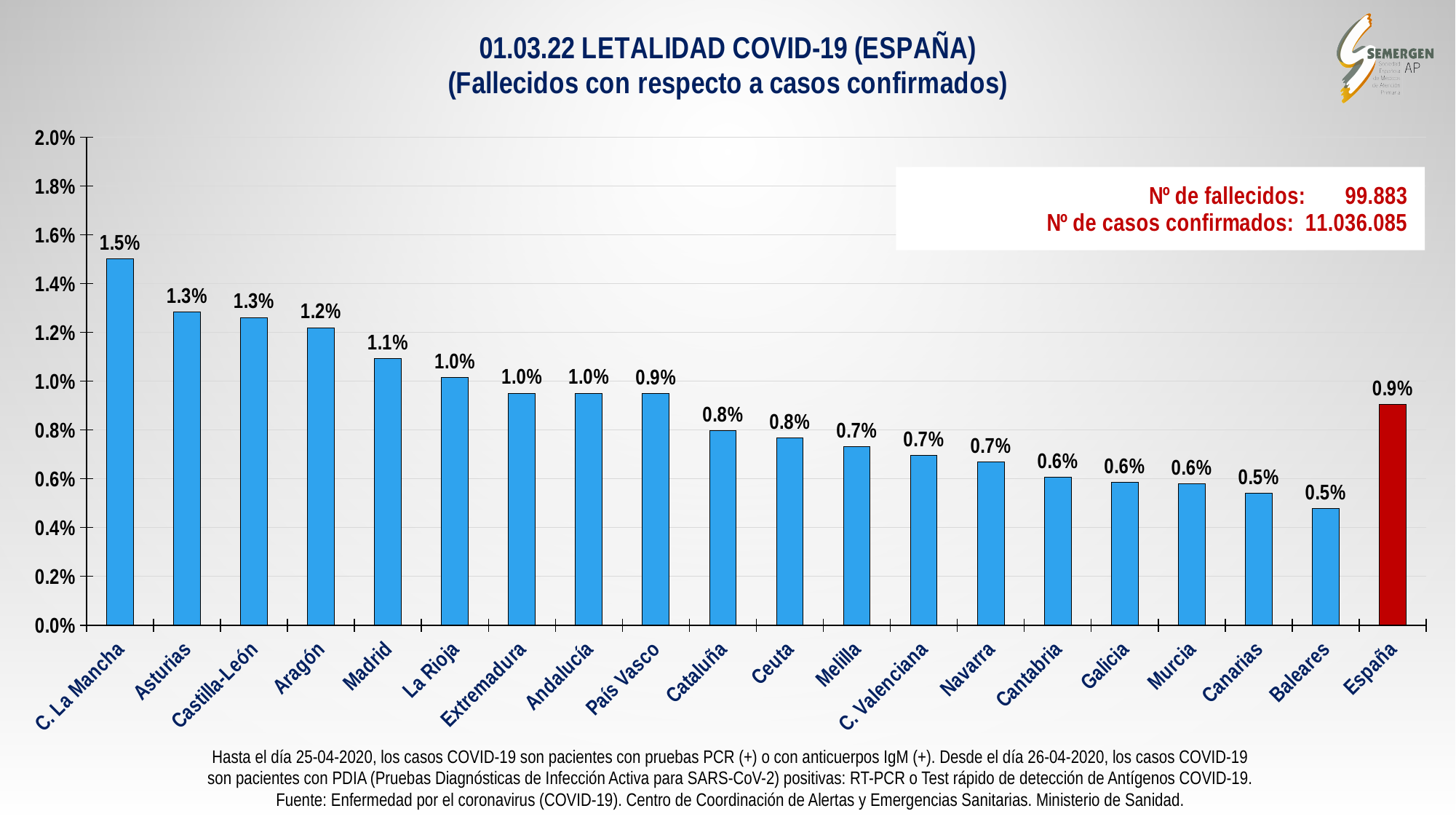
What is the lethality value shown for España? 0.9% Which has a larger value, Aragón or Cataluña? Aragón Is the value for Asturias greater or less than 1.0%? greater What is the difference between the values for C. La Mancha and Madrid? 0.4% Is the value for Galicia greater or less than 0.8%? less What type of chart is shown on the slide? bar chart What is the lethality value shown for Madrid? 1.1% How many categories are plotted on the x axis? 20 What is the value shown for Cataluña? 0.8% Do the values of the regional bars rise or fall from left to right, from C. La Mancha to Baleares? fall Which bar is coloured red instead of blue? España Which category has the highest lethality value? C. La Mancha